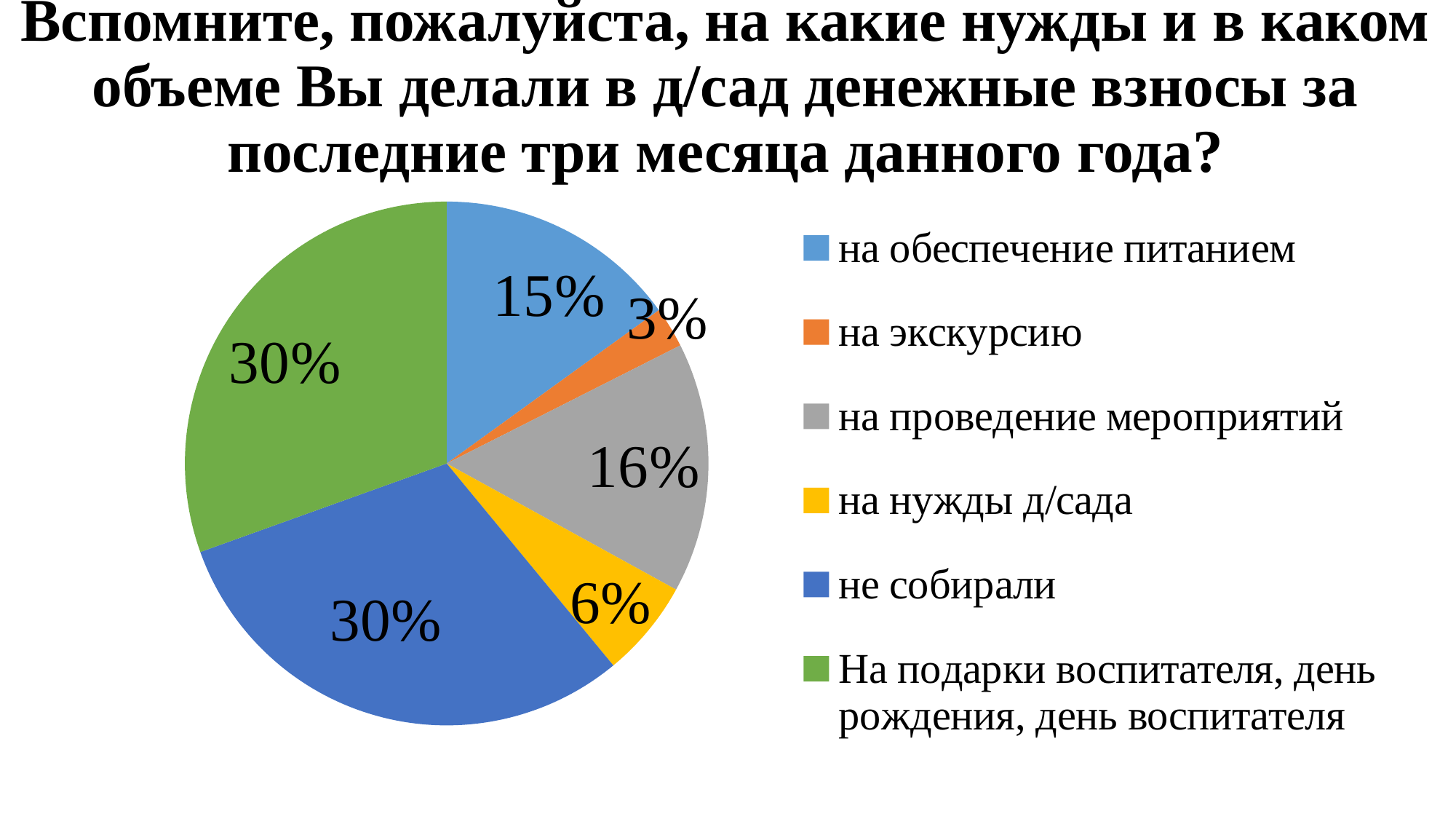
What share of the pie is labelled "на обеспечение питанием"? 15% What percentage is shown for "не собирали"? 30% Which category has the smallest share of the pie? на экскурсию What kind of chart is shown on the slide? pie chart How many slices does the pie chart have? 6 What percentage is shown for "на проведение мероприятий"? 16% What percentage is shown for "на нужды д/сада"? 6% What percentage is shown for "на экскурсию"? 3% Which is larger: the share for "на проведение мероприятий" or the share for "на обеспечение питанием"? на проведение мероприятий What colour is the slice for "не собирали"? blue What is the combined share of "на экскурсию" and "на нужды д/сада"? 9% What is the difference between the share for "не собирали" and the share for "на нужды д/сада"? 24%